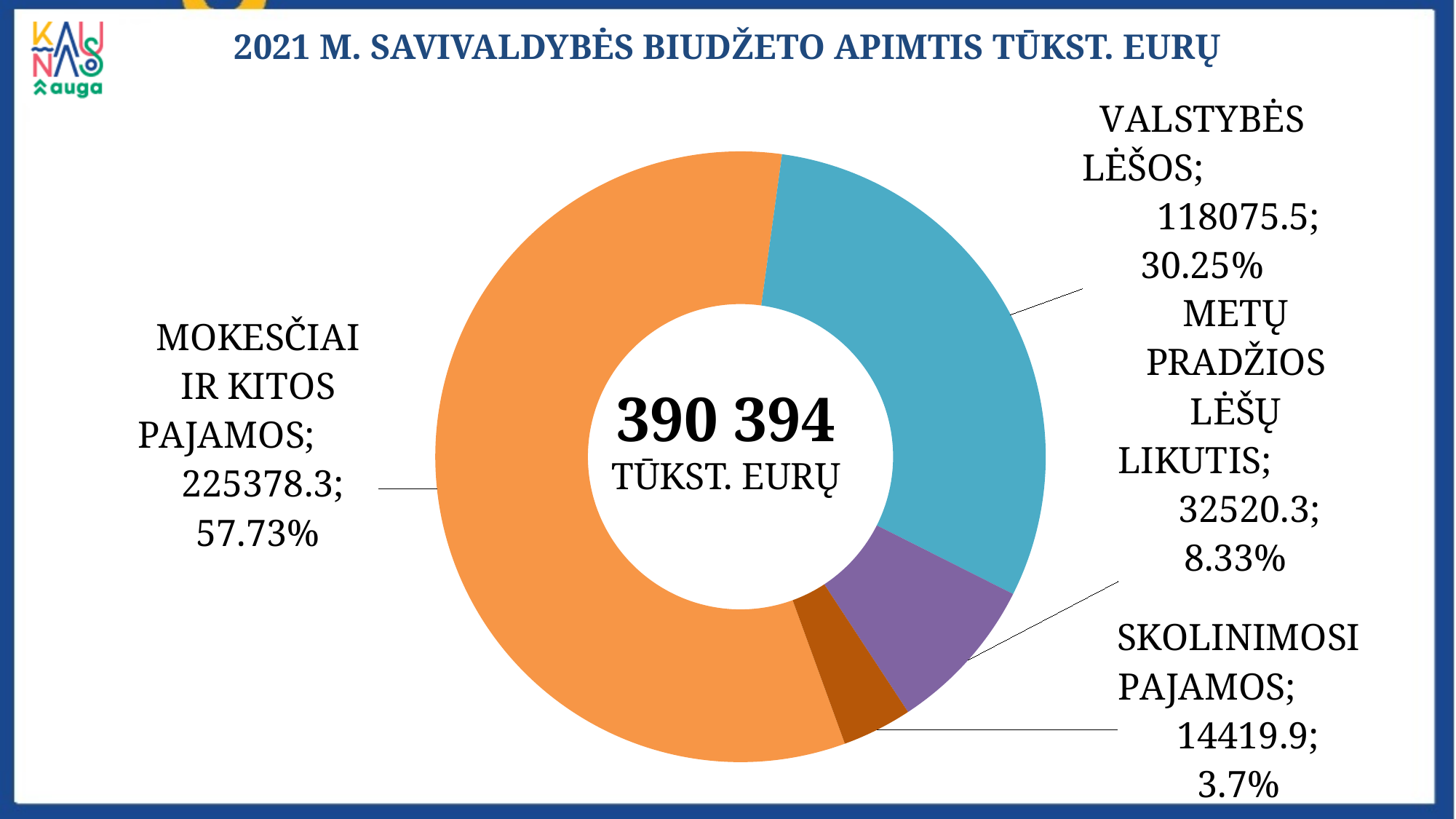
What is the value for METŲ PRADŽIOS LĖŠŲ LIKUTIS? 32520.3 What kind of chart is shown on the slide? Doughnut (pie) chart What share of the chart does VALSTYBĖS LĖŠOS represent? 30.25% What is the value for MOKESČIAI IR KITOS PAJAMOS? 225378.3 What share of the chart does SKOLINIMOSI PAJAMOS represent? 3.7% How many categories are shown in the chart? 4 What is the value for VALSTYBĖS LĖŠOS? 118075.5 What is the difference between MOKESČIAI IR KITOS PAJAMOS and VALSTYBĖS LĖŠOS? 107302.8 What is the value for SKOLINIMOSI PAJAMOS? 14419.9 Which category has the largest slice? MOKESČIAI IR KITOS PAJAMOS Which category has the smallest slice? SKOLINIMOSI PAJAMOS What total value is shown in the centre of the chart? 390 394 TŪKST. EURŲ